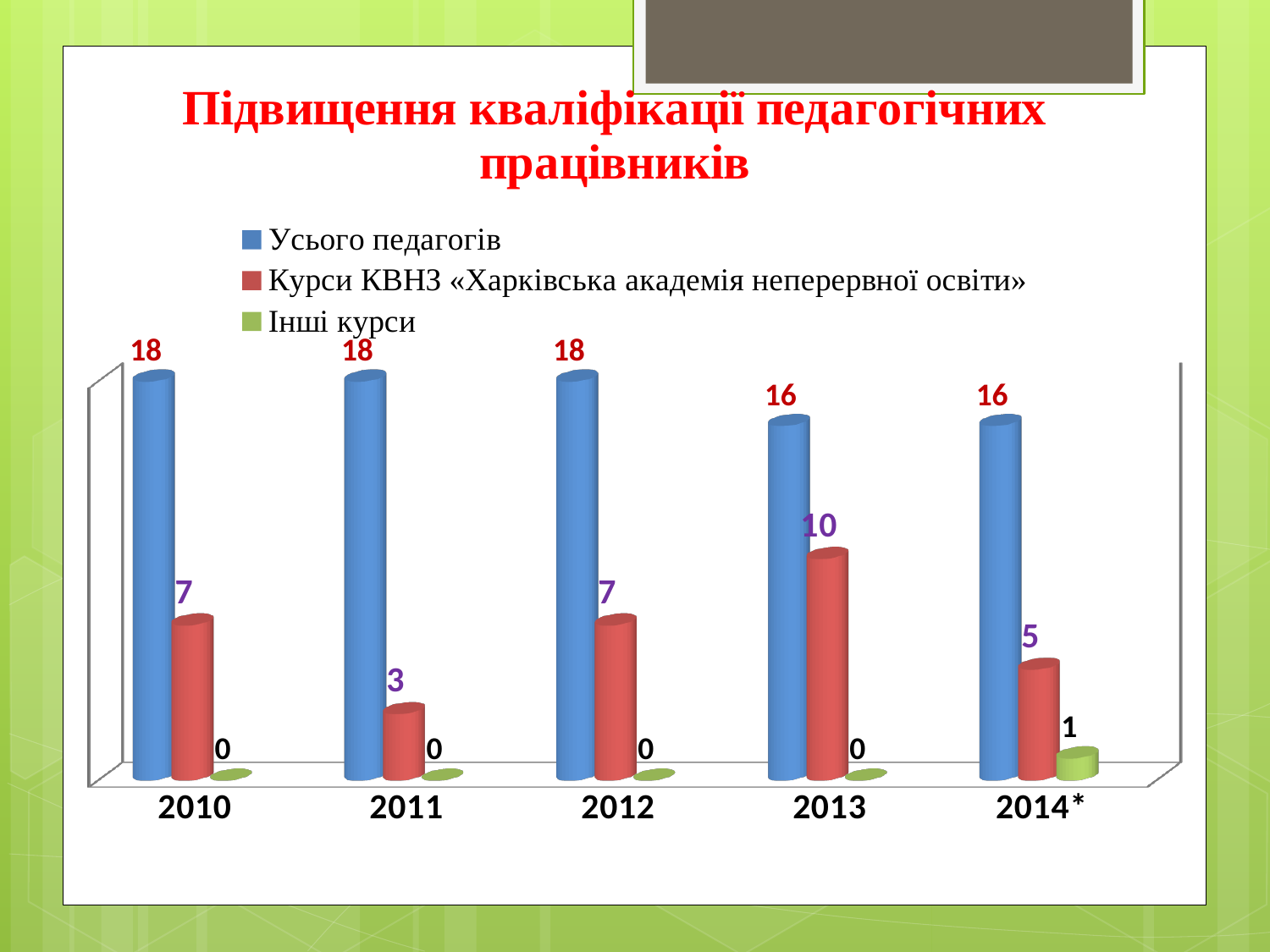
How many years are shown on the x axis? 5 In which year is the value for "Курси КВНЗ «Харківська академія неперервної освіти»" highest? 2013 In which year is the value for "Курси КВНЗ «Харківська академія неперервної освіти»" lowest? 2011 What is the value for "Інші курси" in 2014*? 1 What kind of chart is shown on the slide? bar chart Which is larger: the value for "Курси КВНЗ «Харківська академія неперервної освіти»" in 2012 or in 2014*? 2012 What is the value for "Усього педагогів" in 2010? 18 What is the difference between "Усього педагогів" and "Курси КВНЗ «Харківська академія неперервної освіти»" in 2013? 6 How many series does the legend list? 3 What is the value for "Курси КВНЗ «Харківська академія неперервної освіти»" in 2013? 10 Does the value for "Усього педагогів" rise or fall from 2012 to 2013? fall What is the value for "Курси КВНЗ «Харківська академія неперервної освіти»" in 2011? 3